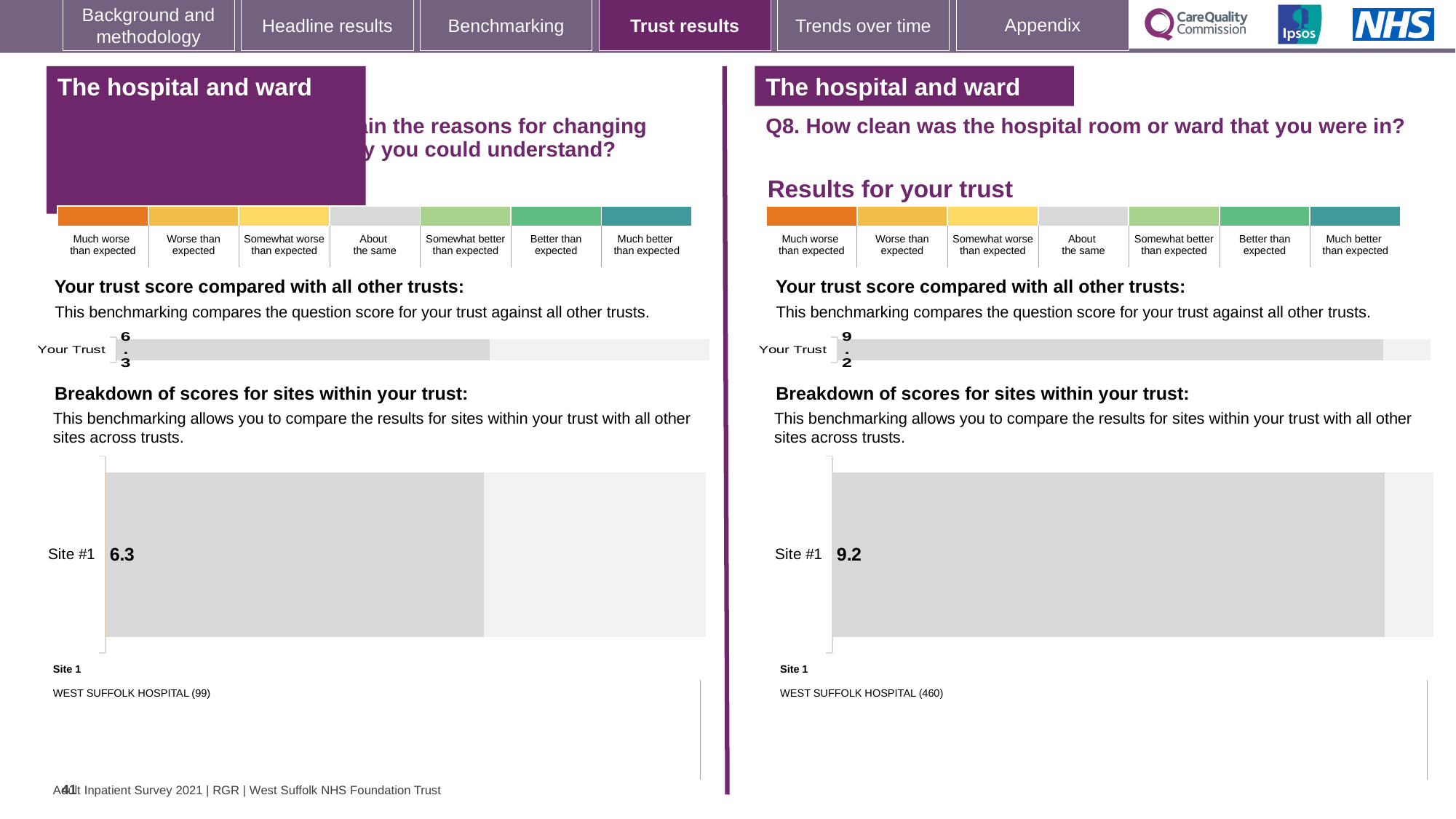
How many sites are shown in the breakdown of scores chart on the right-hand side (Q8)? 1 Which is larger: the Site #1 score on the left-hand chart or the Site #1 score on the right-hand chart (Q8)? Right-hand chart (Q8) What is the difference between the Site #1 score on the right-hand chart (Q8) and the Site #1 score on the left-hand chart? 2.9 On the left-hand side of the slide, what score is shown for Site #1 in the breakdown of scores for sites within your trust? 6.3 On the left-hand side of the slide, what is the score shown for Your Trust? 6.3 How many sites are shown in the breakdown of scores chart on the left-hand side? 1 On the right-hand side (Q8), which site name is listed as Site 1 below the chart? WEST SUFFOLK HOSPITAL (460) Is the Your Trust score on the right-hand side (Q8) greater or less than the Your Trust score on the left-hand side? greater On the left-hand side, which site name is listed as Site 1 below the chart? WEST SUFFOLK HOSPITAL (99) On the right-hand side (Q8, how clean was the hospital room or ward), what is the score shown for Your Trust? 9.2 What kind of chart is used to show the Site #1 score on the right-hand side (Q8)? Bar chart On the right-hand side (Q8), what score is shown for Site #1 in the breakdown of scores for sites within your trust? 9.2